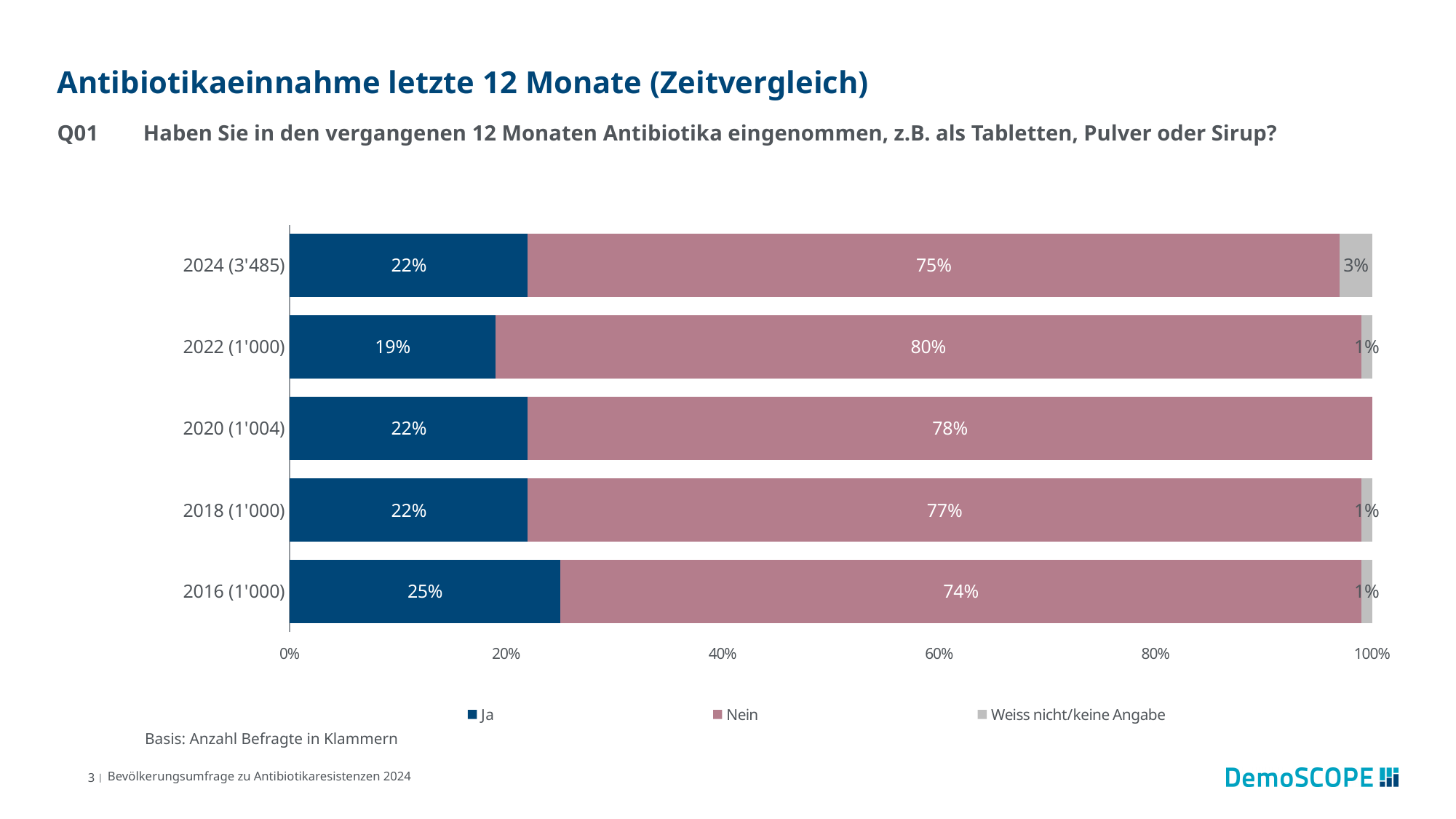
How many series does the legend list? 3 What percentage of respondents answered "Ja" in 2024 (3'485)? 22% What kind of chart is shown on the slide? Stacked bar chart What is the difference in percentage points between the "Ja" share in 2016 (1'000) and in 2022 (1'000)? 6 percentage points Which year has the highest "Nein" share? 2022 (1'000) What is the "Weiss nicht/keine Angabe" value for 2024 (3'485)? 3% What is the "Nein" value for 2022 (1'000)? 80% Which year has the highest "Ja" share? 2016 (1'000) Which year has the lowest "Ja" share? 2022 (1'000) Which is larger: the "Nein" share in 2024 (3'485) or in 2022 (1'000)? 2022 (1'000) What is the total of the stacked bar for 2018 (1'000)? 100% How many years (categories) are shown in the chart? 5